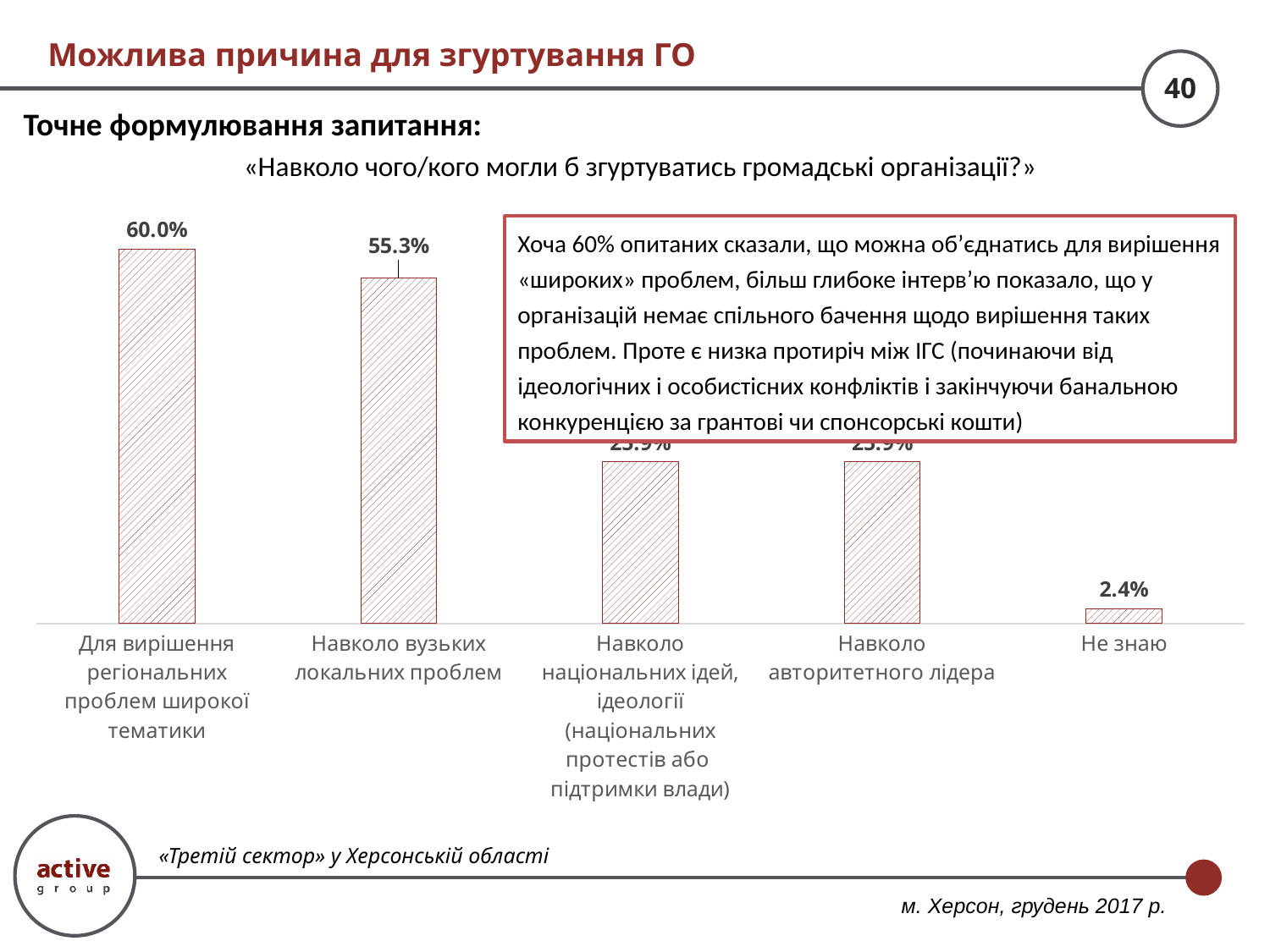
Do the values rise or fall from left to right along the x axis? fall Which category has the highest value? Для вирішення регіональних проблем широкої тематики Which category has the lowest value? Не знаю What is the value for «Для вирішення регіональних проблем широкої тематики»? 60.0% What is the difference between the values for «Для вирішення регіональних проблем широкої тематики» and «Навколо вузьких локальних проблем»? 4.7 percentage points Which is larger: the value for «Навколо авторитетного лідера» or the value for «Не знаю»? Навколо авторитетного лідера What is the difference between the values for «Для вирішення регіональних проблем широкої тематики» and «Не знаю»? 57.6 percentage points How many categories are shown in the chart? 5 What is the value for «Навколо вузьких локальних проблем»? 55.3% What survey question is the chart based on, as stated on the slide? «Навколо чого/кого могли б згуртуватись громадські організації?» What kind of chart is shown on the slide? bar chart What is the value for «Не знаю»? 2.4%